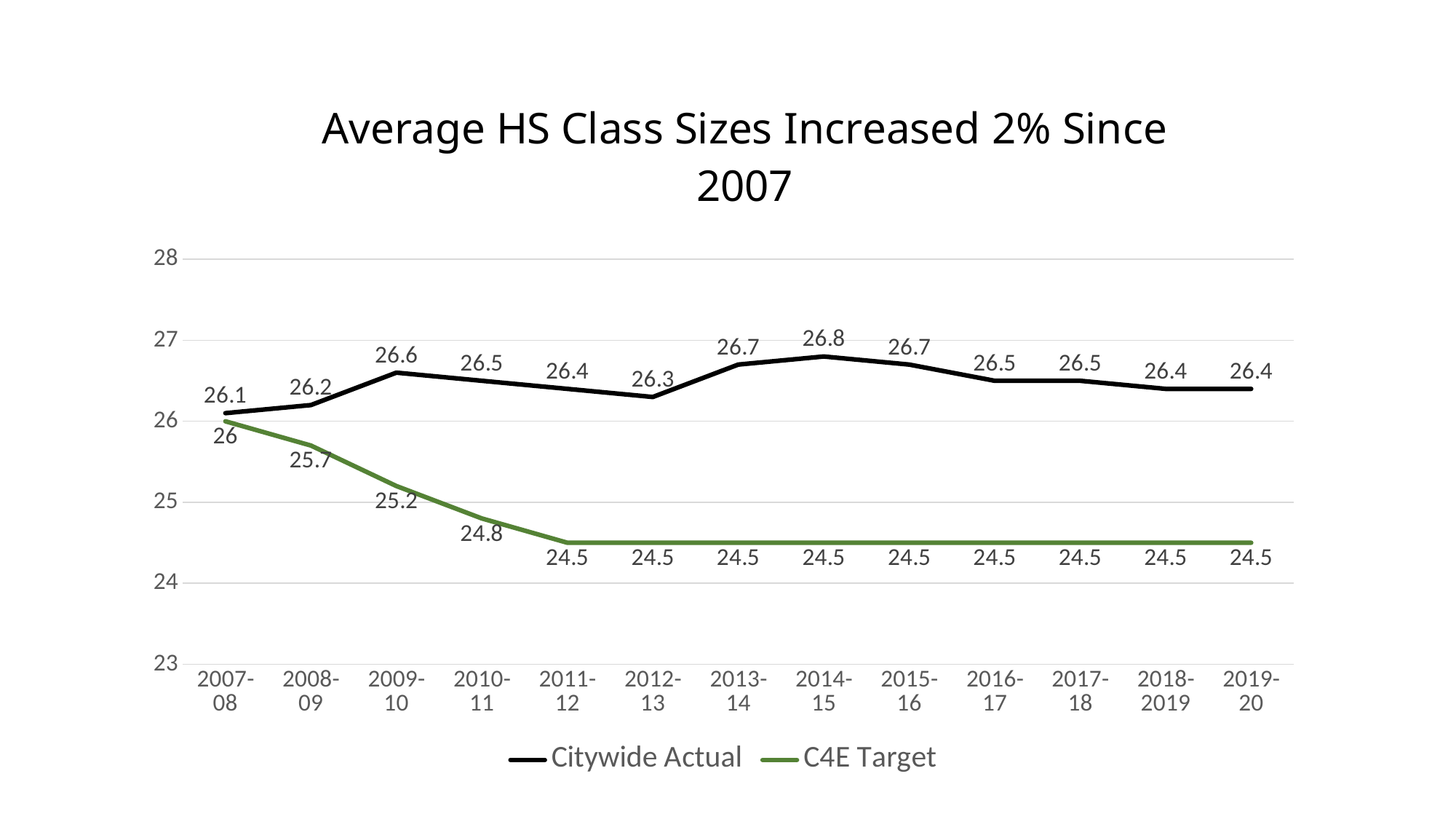
What is the difference between the Citywide Actual and C4E Target values in 2019-20? 1.9 How many school years are shown on the x axis? 13 In which year is the Citywide Actual value highest? 2014-15 What is the Citywide Actual value for 2014-15? 26.8 What kind of chart is this? line chart How many series does the legend list? 2 What is the Citywide Actual value for 2007-08? 26.1 Which is larger in 2009-10, the Citywide Actual or the C4E Target? Citywide Actual In which year is the Citywide Actual value lowest? 2007-08 Does the C4E Target line rise or fall from 2007-08 to 2011-12? fall What is the C4E Target value for 2008-09? 25.7 Is the C4E Target value for 2011-12 greater or less than 25? less